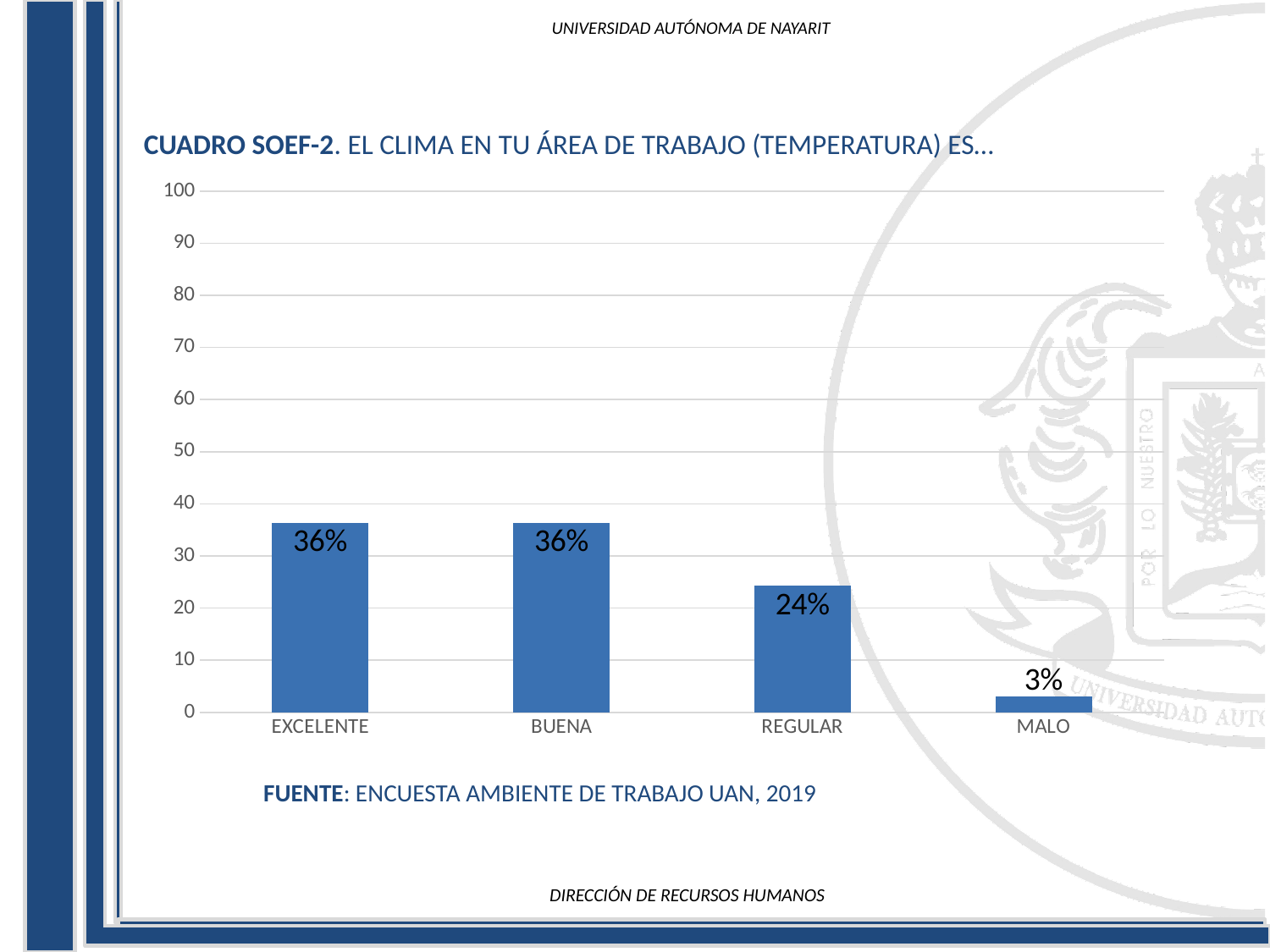
How many categories are shown on the x axis? 4 What is the value for EXCELENTE? 36% Do the values rise or fall from EXCELENTE to MALO along the x axis? fall Which is larger, the value for REGULAR or the value for MALO? REGULAR Is the value for REGULAR greater or less than 30? less What is the difference between the values for REGULAR and MALO? 21% What kind of chart is shown on the slide? bar chart What is the value for REGULAR? 24% What is the value for MALO? 3% Which category has the lowest value? MALO What is the difference between the values for BUENA and REGULAR? 12% What is the source cited below the chart? ENCUESTA AMBIENTE DE TRABAJO UAN, 2019